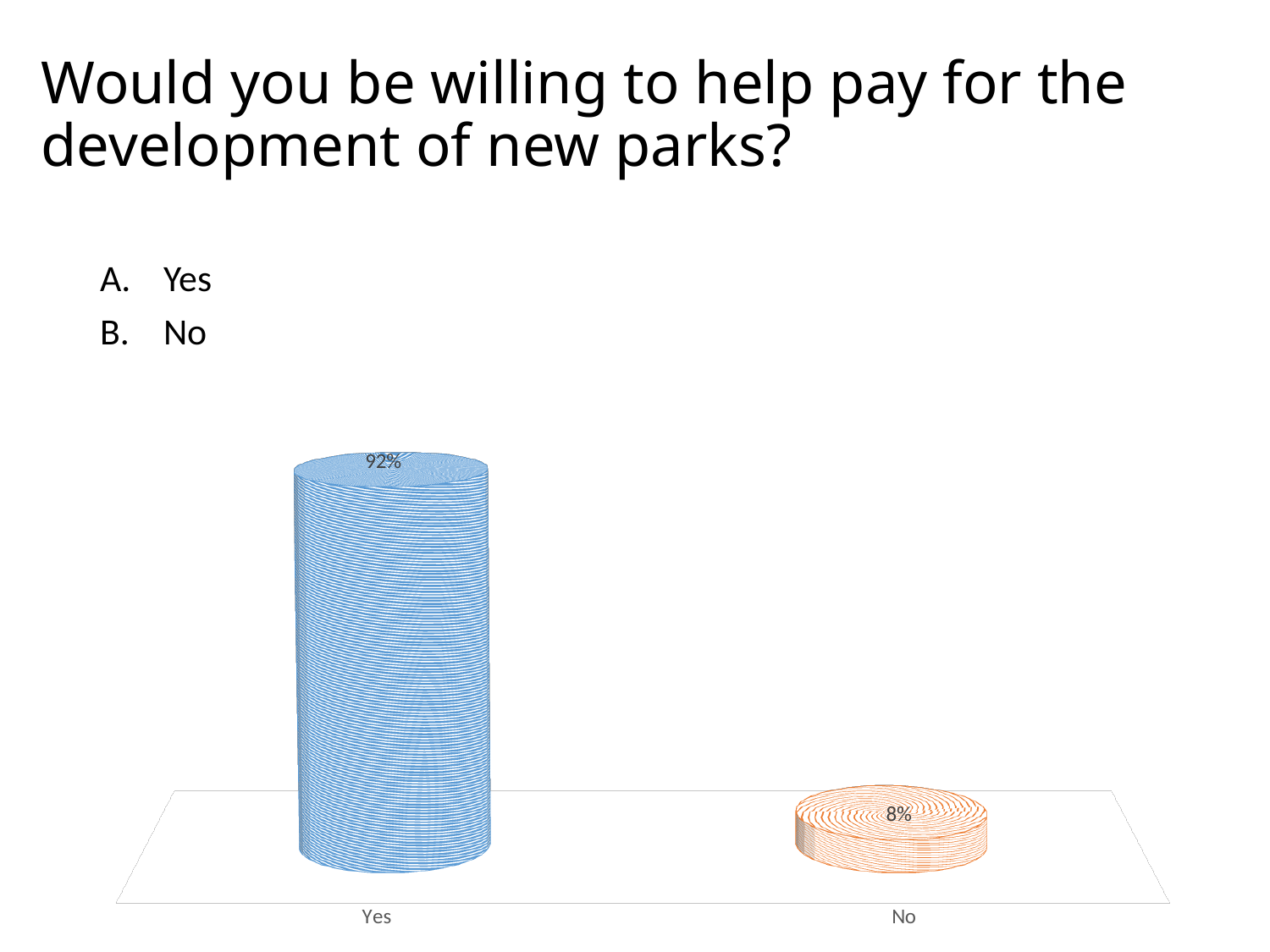
What colour is the bar for No? Orange What is the difference between the Yes and No percentages? 84% Which category has the lowest value? No What colour is the bar for Yes? Blue What kind of chart is shown on the slide? Bar chart Which category has the highest value? Yes How many categories are shown in the chart? 2 What percentage of respondents answered Yes? 92% What percentage of respondents answered No? 8% Which is larger, the value for Yes or the value for No? Yes What is the total of the Yes and No percentages? 100%